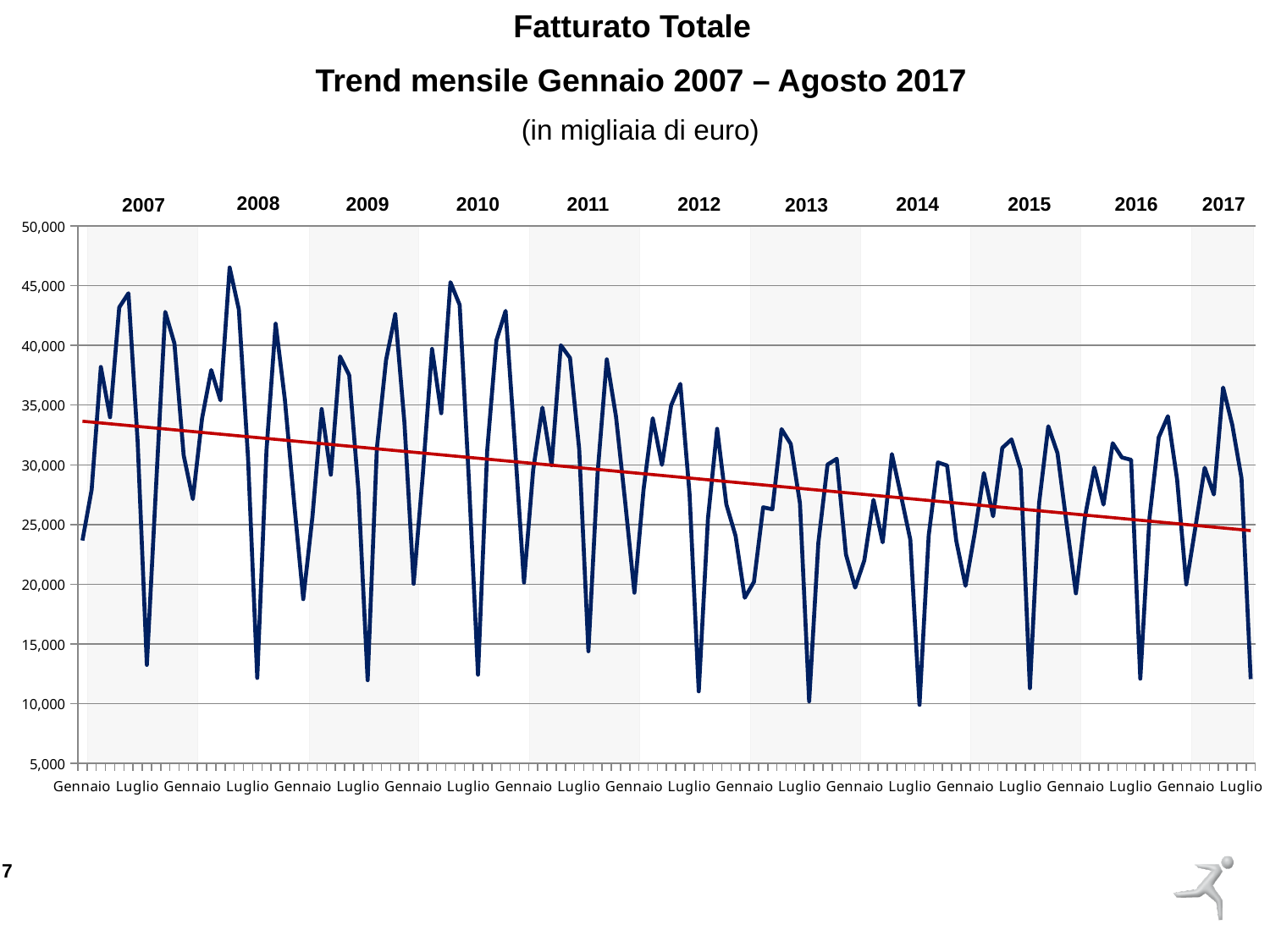
In which year does the line reach its highest peak? 2008 In what unit are the values expressed, according to the subtitle? in migliaia di euro Is the red trend line at the start of 2007 greater or less than 30,000? greater What kind of chart is shown on the slide? line chart Is the lowest point of the line in 2013 greater or less than 15,000? less According to the red trend line, do the values rise or fall from 2007 to 2017? fall Is the highest peak of the line in 2015 greater or less than 35,000? less What is the title of the chart? Fatturato Totale Is the highest peak of the line in 2008 larger than the highest peak in 2015? yes How many year labels are shown along the top of the chart? 11